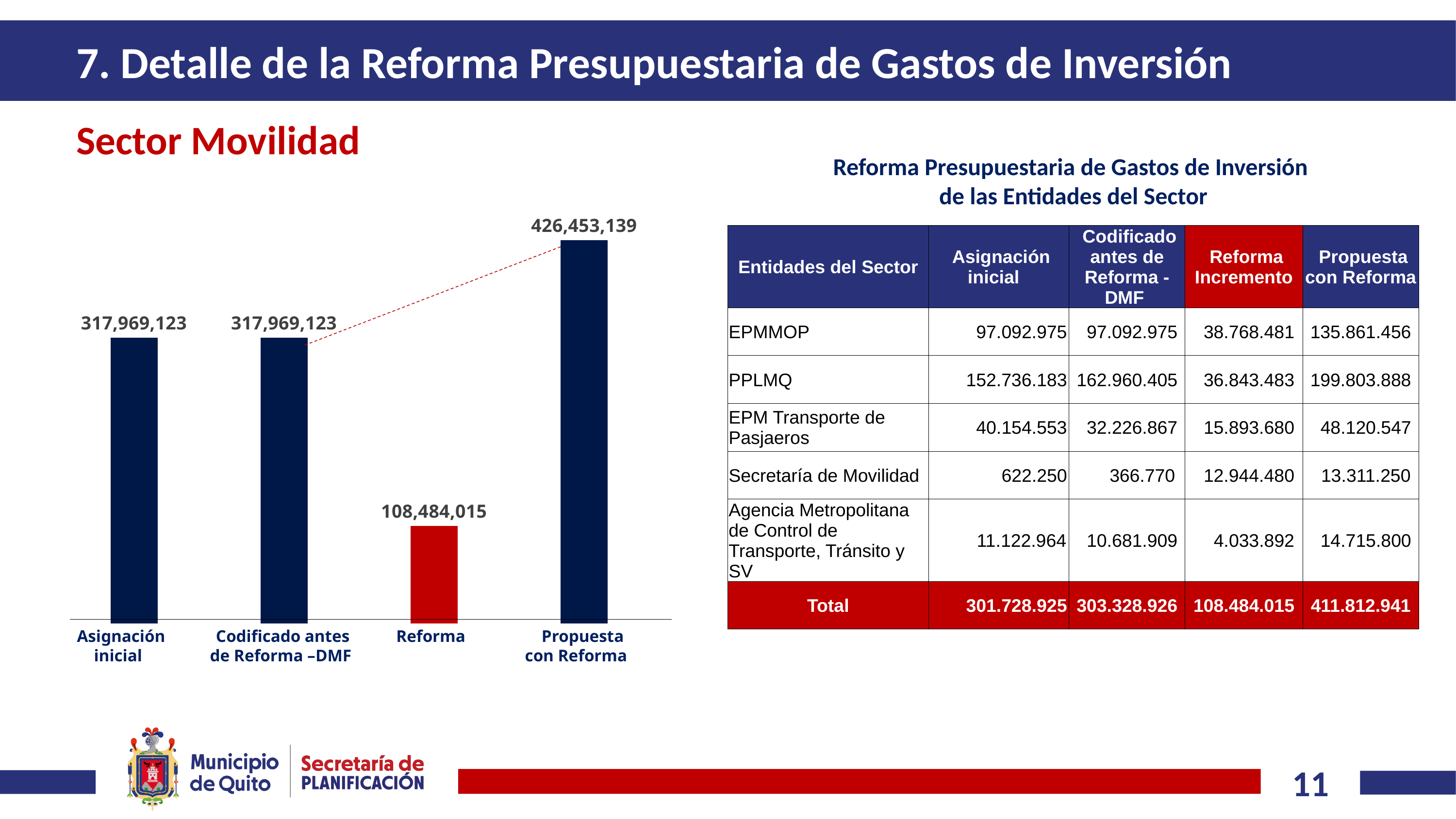
Which bar in the chart is coloured red? Reforma What value is shown for Propuesta con Reforma in the bar chart? 426,453,139 Which category has the highest value in the bar chart? Propuesta con Reforma What value is shown for Asignación inicial in the bar chart? 317,969,123 In the bar chart, which is larger: Propuesta con Reforma or Asignación inicial? Propuesta con Reforma What is the difference between the Propuesta con Reforma value and the Reforma value in the bar chart? 317,969,124 What type of chart is shown on the left of the slide? Bar chart What is the difference between the Asignación inicial value and the Reforma value in the bar chart? 209,485,108 How many bars are shown in the bar chart? 4 Which category has the lowest value in the bar chart? Reforma What value is shown for Reforma in the bar chart? 108,484,015 What value is shown for Codificado antes de Reforma –DMF in the bar chart? 317,969,123